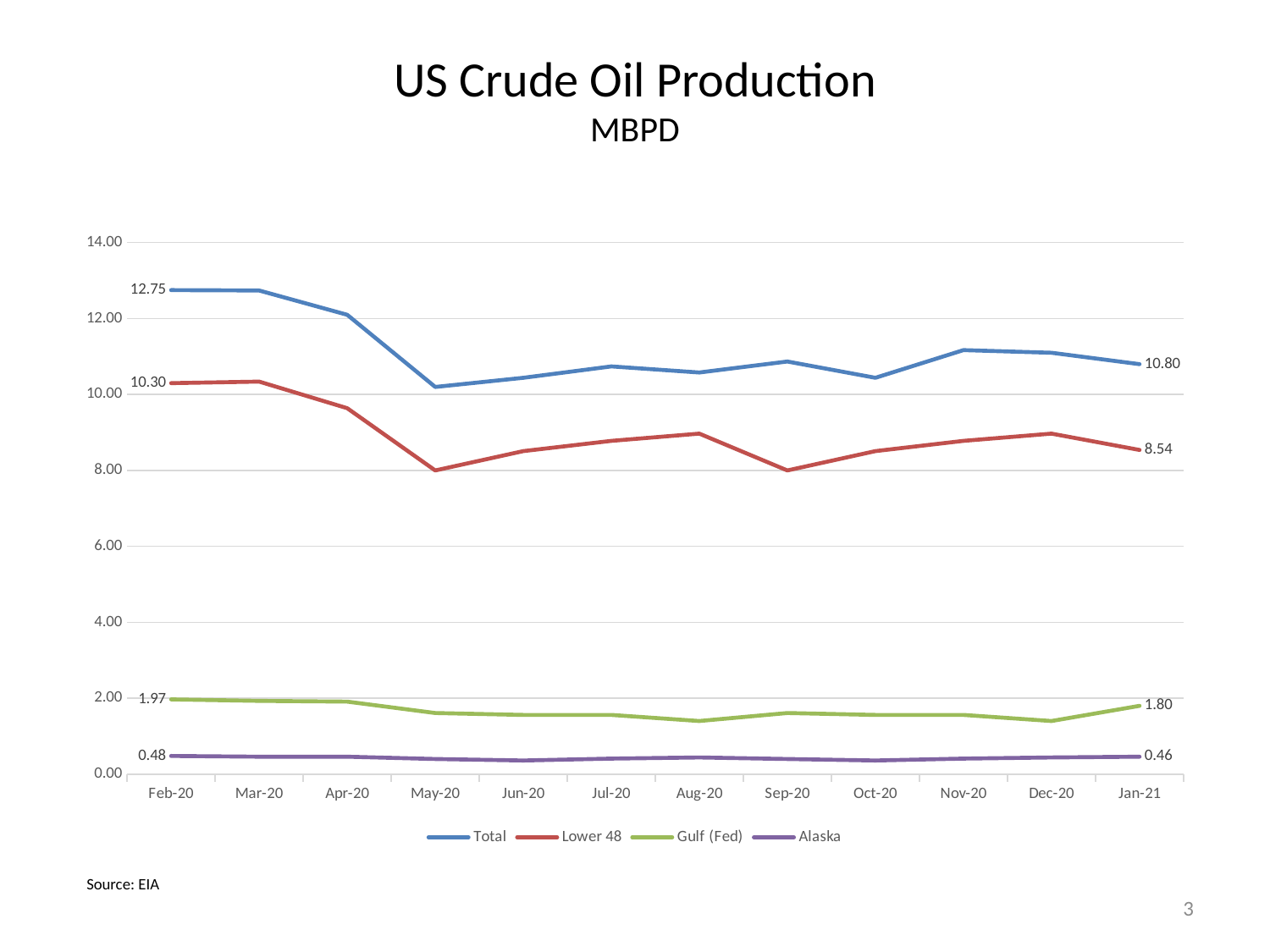
What is the difference between the Lower 48 value in Feb-20 and in Jan-21? 1.76 What is the Total value for Jan-21? 10.80 What is the Lower 48 value for Feb-20? 10.30 What is the Gulf (Fed) value for Jan-21? 1.80 Is the Total value for May-20 greater or less than 12.00? less How many series does the legend list? 4 What is the difference between the Total value in Feb-20 and in Jan-21? 1.95 How many months are shown on the x axis? 12 What is the Total value for Feb-20? 12.75 Is the Lower 48 value for Aug-20 greater or less than 8.00? greater What kind of chart is this? line chart What is the Alaska value for Feb-20? 0.48